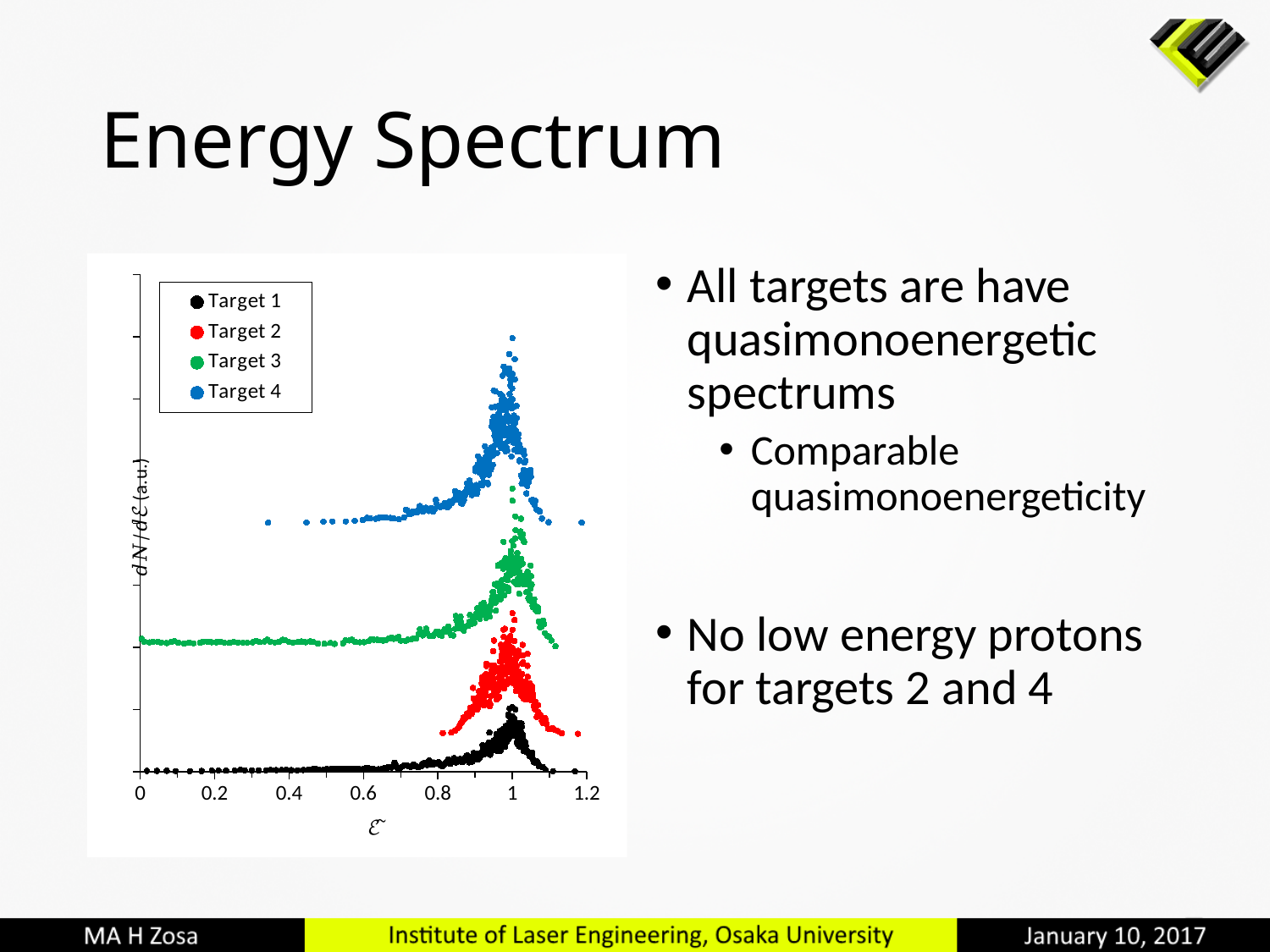
What colour is used for Target 4 in the chart? blue Is the ε position of the peak of the Target 1 series greater or less than 0.6? greater What kind of chart is shown on the slide? scatter plot Which series is plotted at the top of the chart, above all the others? Target 4 What is the highest tick value shown on the x axis? 1.2 What is the label of the x axis? ε What is the title of the slide containing the chart? Energy Spectrum How many series does the legend list? 4 What is the lowest tick value shown on the x axis? 0 Which series is plotted at the bottom of the chart, below all the others? Target 1 How many labelled tick values are on the x axis? 7 Is the ε position of the peak of the Target 4 series greater or less than 0.8? greater